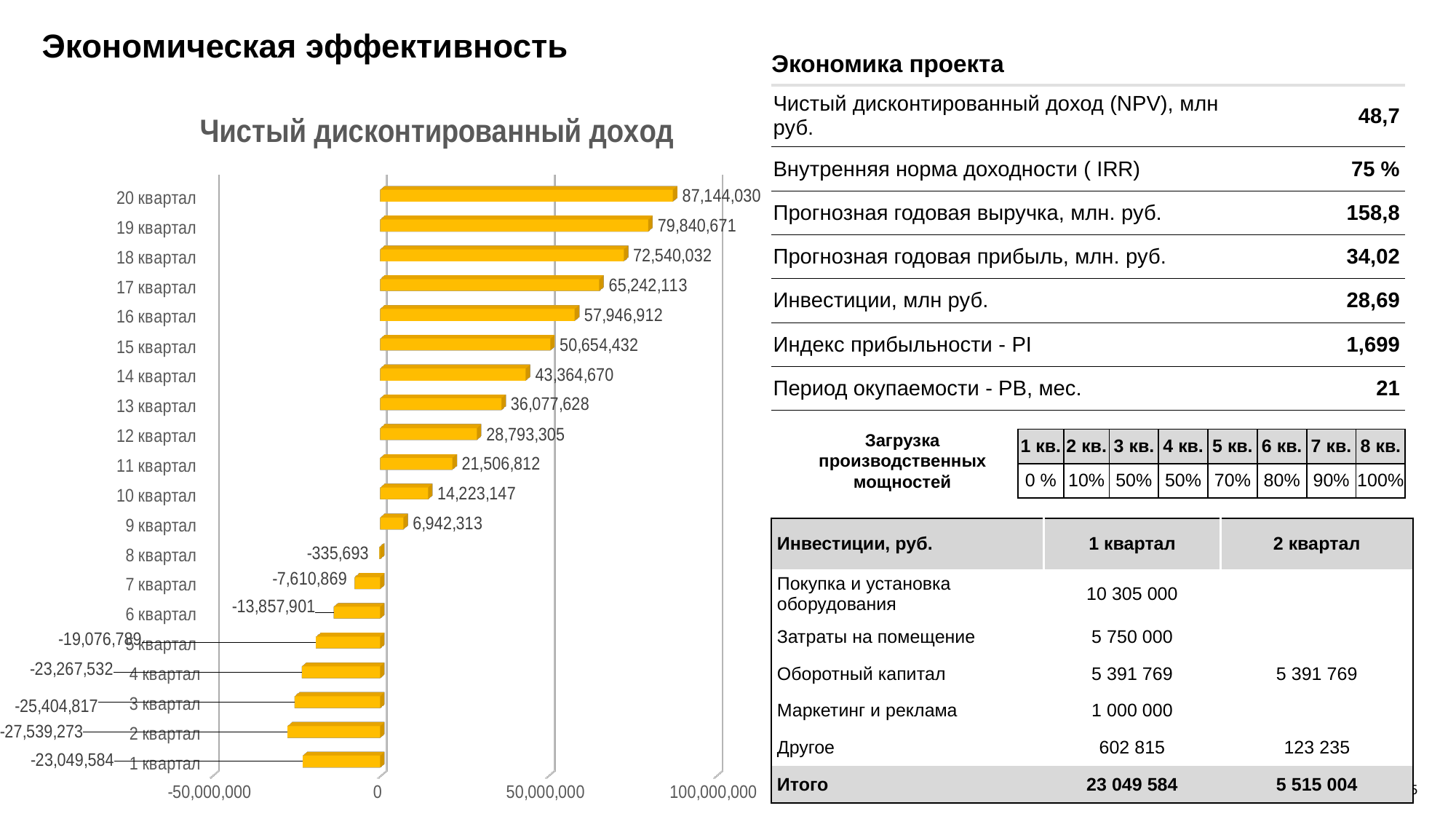
What is the value for 9 квартал in the chart? 6,942,313 What kind of chart is 'Чистый дисконтированный доход'? bar chart What is the difference between the values for 20 квартал and 19 квартал? 7,303,359 Which quarter has the lowest value in the chart? 2 квартал What is the value for 2 квартал in the chart? -27,539,273 What is the difference between the values for 10 квартал and 9 квартал? 7,280,834 From 9 квартал to 20 квартал, do the values rise or fall? rise Which quarter has the highest value in the chart? 20 квартал Is the value for 15 квартал greater or less than 50,000,000? greater What is the value for 20 квартал in the chart 'Чистый дисконтированный доход'? 87,144,030 How many quarters are shown in the chart? 20 Which is larger, the value for 13 квартал or the value for 12 квартал? 13 квартал